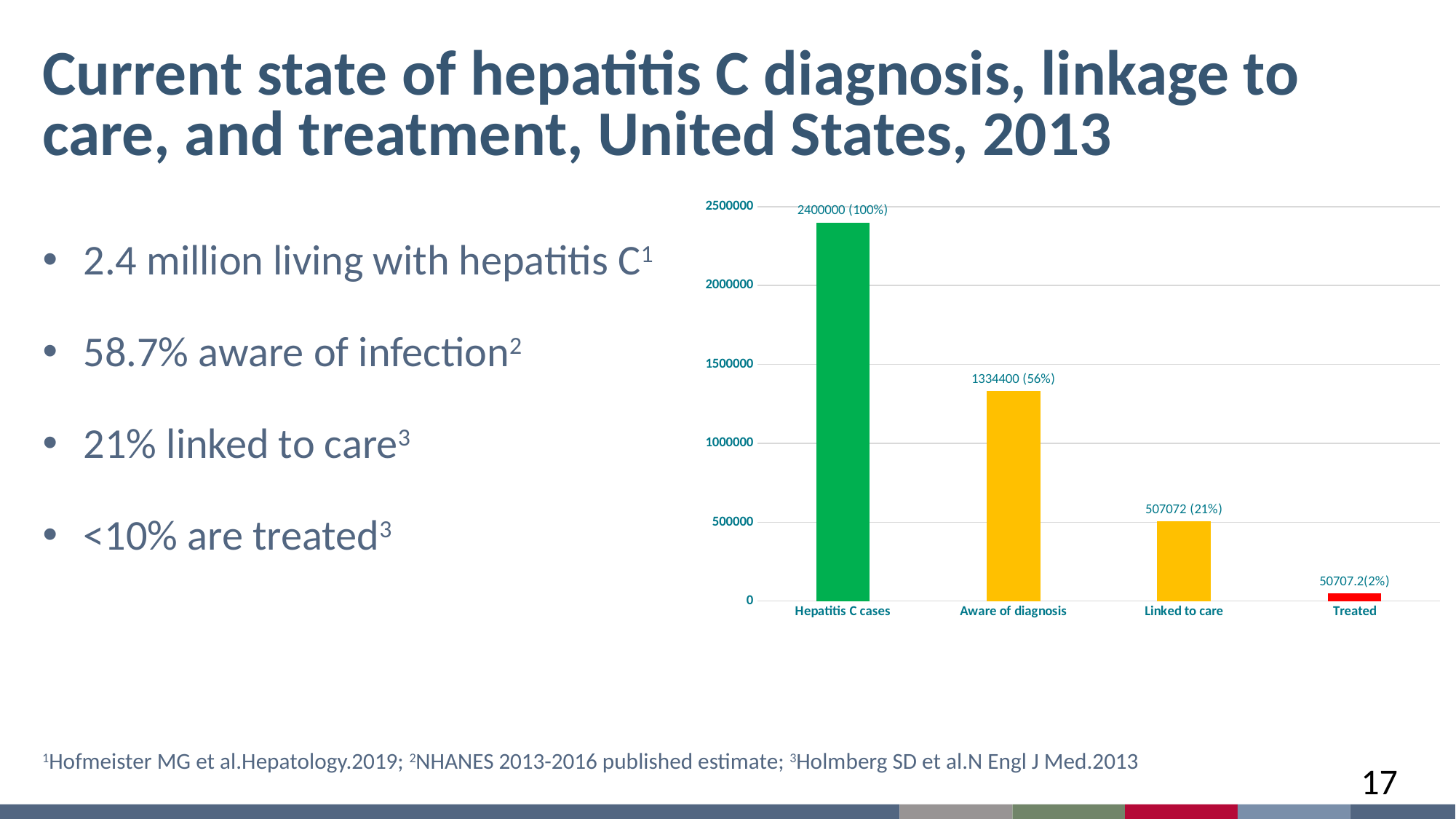
Which category has the lowest value in the chart? Treated Do the bar values rise or fall from left to right along the x axis? fall What is the data label shown for the Hepatitis C cases bar? 2400000 (100%) What kind of chart is shown on the slide? bar chart What is the data label shown for the Treated bar? 50707.2(2%) What is the data label shown for the Linked to care bar? 507072 (21%) Which is larger, the value for Aware of diagnosis or the value for Linked to care? Aware of diagnosis How many categories are shown on the x axis of the chart? 4 Is the value for Linked to care greater or less than 1000000? less Which category has the highest value in the chart? Hepatitis C cases What is the data label shown for the Aware of diagnosis bar? 1334400 (56%) What is the difference between the Hepatitis C cases value and the Aware of diagnosis value? 1065600